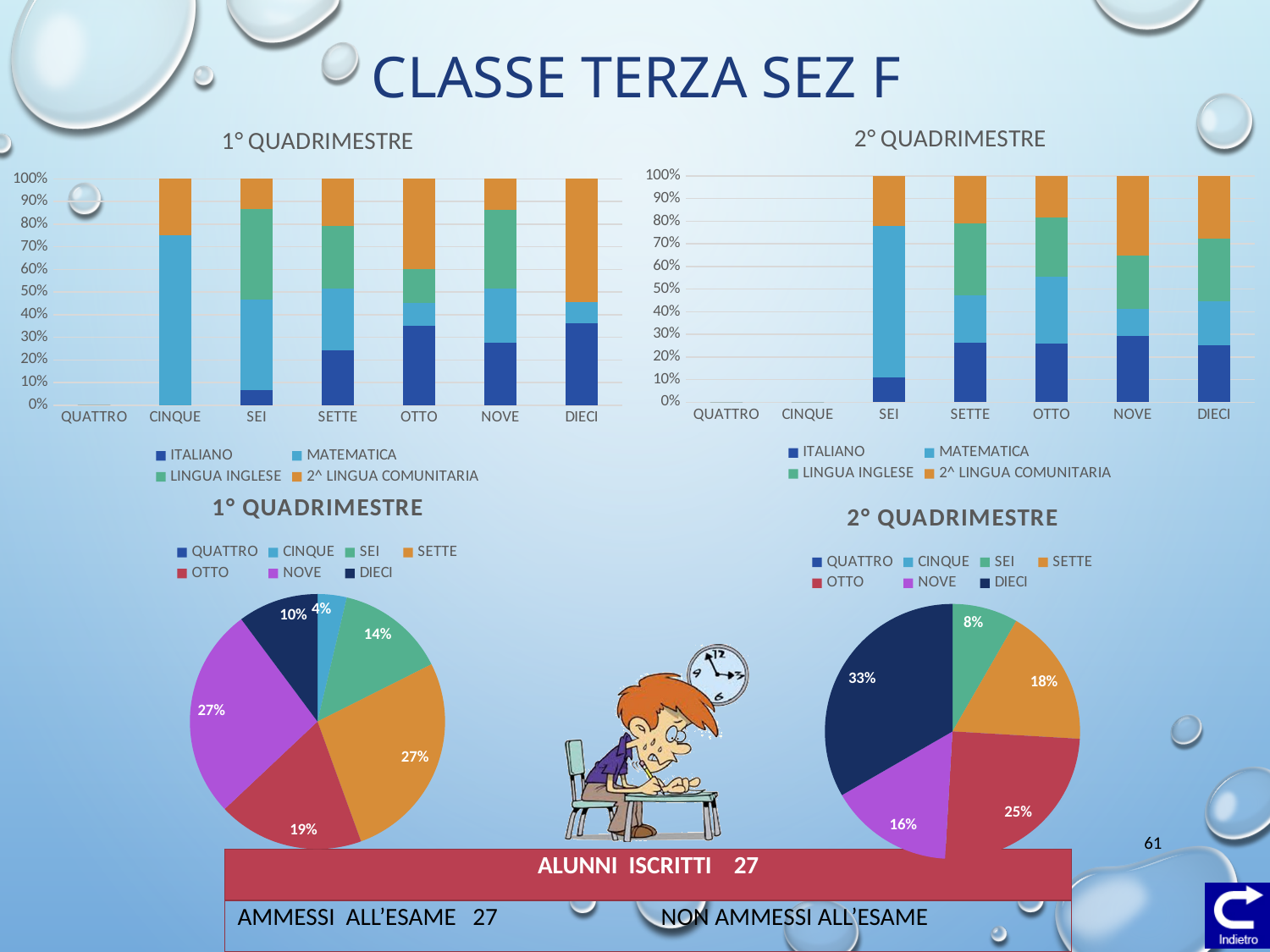
In the top-left 1° QUADRIMESTRE bar chart, is the ITALIANO value for SEI greater or less than 10%? less In the 1° QUADRIMESTRE pie chart, which is larger, OTTO or DIECI? OTTO In the 1° QUADRIMESTRE pie chart, what share does SETTE have? 27% How many series does the legend of the top-left 1° QUADRIMESTRE bar chart list? 4 In the 2° QUADRIMESTRE pie chart, what is the value for OTTO? 25% In the 2° QUADRIMESTRE pie chart, which slice is the largest? DIECI In the top-right 2° QUADRIMESTRE bar chart, is the ITALIANO value for SETTE greater or less than 30%? less How many categories are shown on the x axis of the top-right 2° QUADRIMESTRE bar chart? 7 What kind of chart is the top-left chart titled 1° QUADRIMESTRE? Stacked bar chart How many entries does the legend of the 2° QUADRIMESTRE pie chart list? 7 In the 1° QUADRIMESTRE pie chart, which labelled slice is the smallest? CINQUE In the 2° QUADRIMESTRE pie chart, what is the difference between the DIECI slice and the SEI slice? 25 percentage points